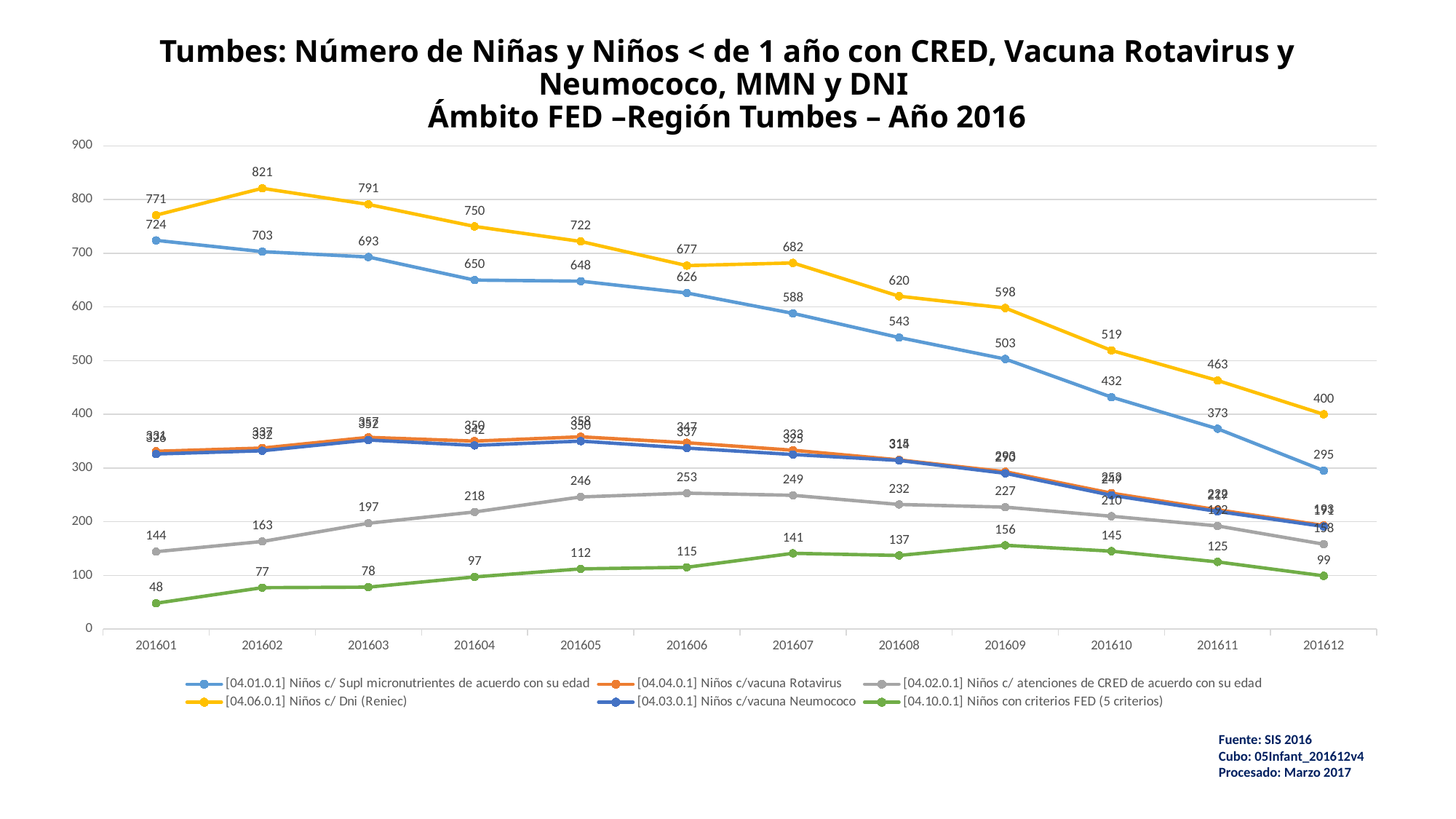
Does the Niños c/ Supl micronutrientes de acuerdo con su edad series rise or fall from 201601 to 201612? fall What is the difference between the Niños c/ Dni (Reniec) values in 201601 and 201612? 371 How many months (x-axis points) are plotted on the chart? 12 What is the value for Niños c/ Supl micronutrientes de acuerdo con su edad in 201612? 295 How many series does the legend list? 6 What kind of chart is shown on the slide? line chart In which month does the Niños c/ Dni (Reniec) series reach its highest value? 201602 What is the value for Niños c/ Dni (Reniec) in 201602? 821 What is the value for Niños con criterios FED (5 criterios) in 201609? 156 In 201606, which is larger: Niños c/ atenciones de CRED de acuerdo con su edad or Niños con criterios FED (5 criterios)? Niños c/ atenciones de CRED de acuerdo con su edad What is the value for Niños c/ atenciones de CRED de acuerdo con su edad in 201604? 218 In which month is the Niños con criterios FED (5 criterios) series at its lowest? 201601